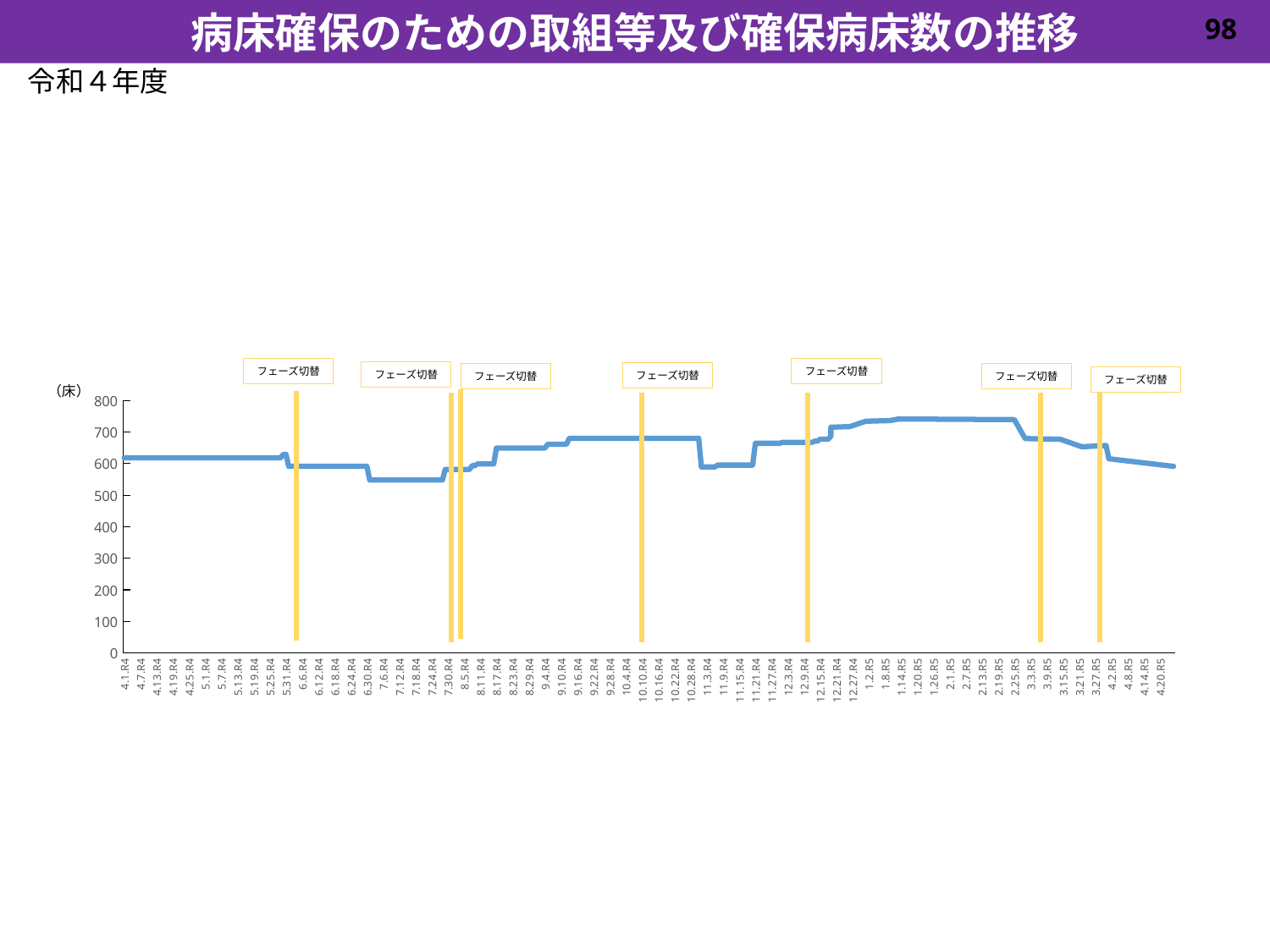
Does the line rise or fall between 2.25.R5 and 4.20.R5? fall What kind of chart is shown on the slide? line chart Does the line rise or fall between 12.15.R4 and 1.20.R5? rise What unit is shown on the y axis of the chart? 床 Is the value for 4.1.R4 greater or less than 600? greater How many フェーズ切替 (phase switch) markers are shown on the chart? 7 Is the value for 9.22.R4 greater or less than 600? greater What is the highest tick value shown on the y axis? 800 Is the value for 1.20.R5 greater or less than 700? greater